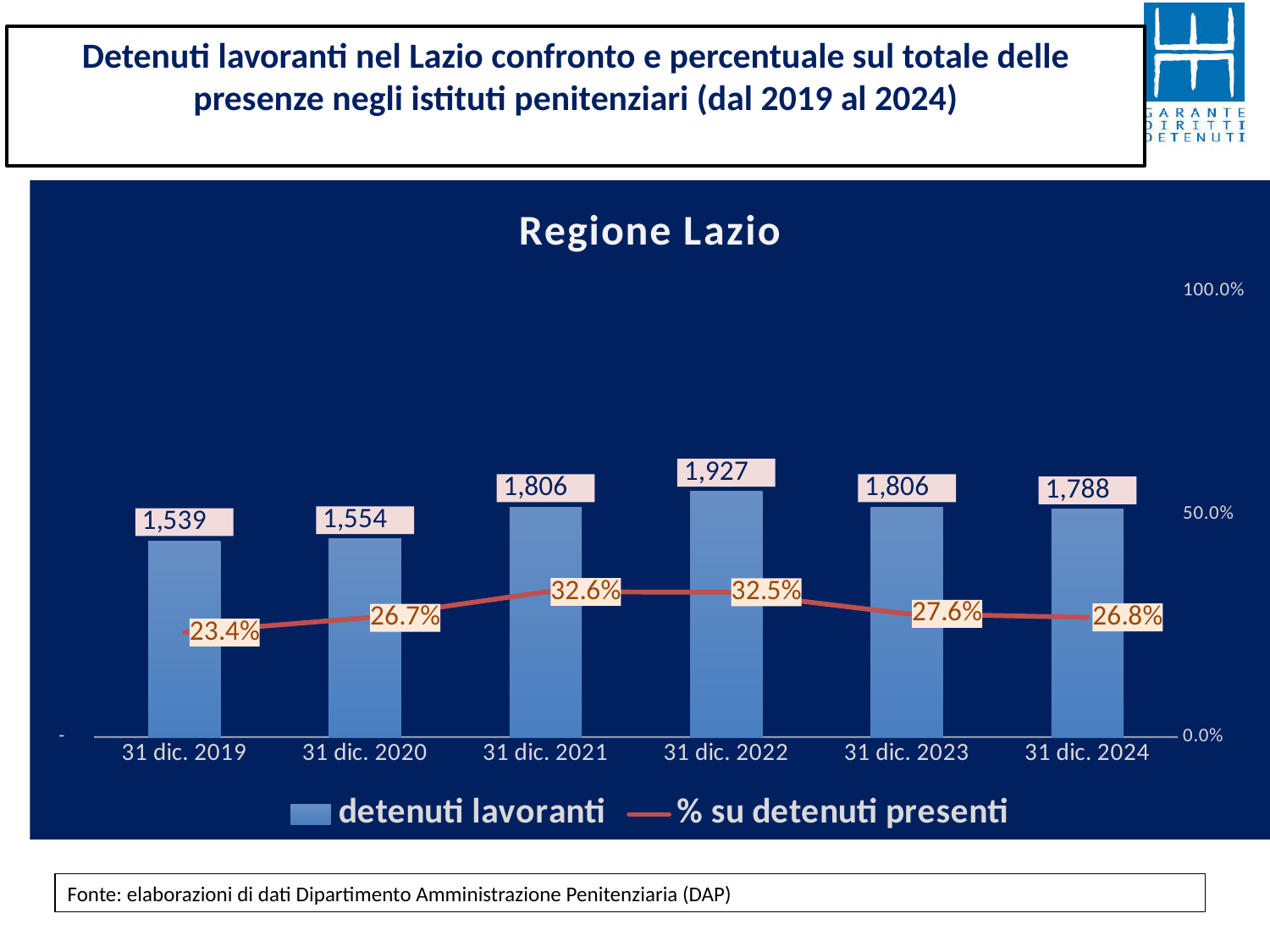
How many series does the legend list? 2 On which date is the number of detenuti lavoranti highest? 31 dic. 2022 What kind of chart is used for the detenuti lavoranti series? bar chart What is the difference in detenuti lavoranti between 31 dic. 2022 and 31 dic. 2019? 388 What is the title shown inside the chart area? Regione Lazio What is the % su detenuti presenti on 31 dic. 2019? 23.4% On which date is the % su detenuti presenti lowest? 31 dic. 2019 How many dates are shown on the x axis? 6 What is the value of detenuti lavoranti on 31 dic. 2022? 1,927 What is the value of detenuti lavoranti on 31 dic. 2024? 1,788 Does the % su detenuti presenti rise or fall from 31 dic. 2022 to 31 dic. 2024? fall Which is larger, the detenuti lavoranti on 31 dic. 2020 or on 31 dic. 2023? 31 dic. 2023